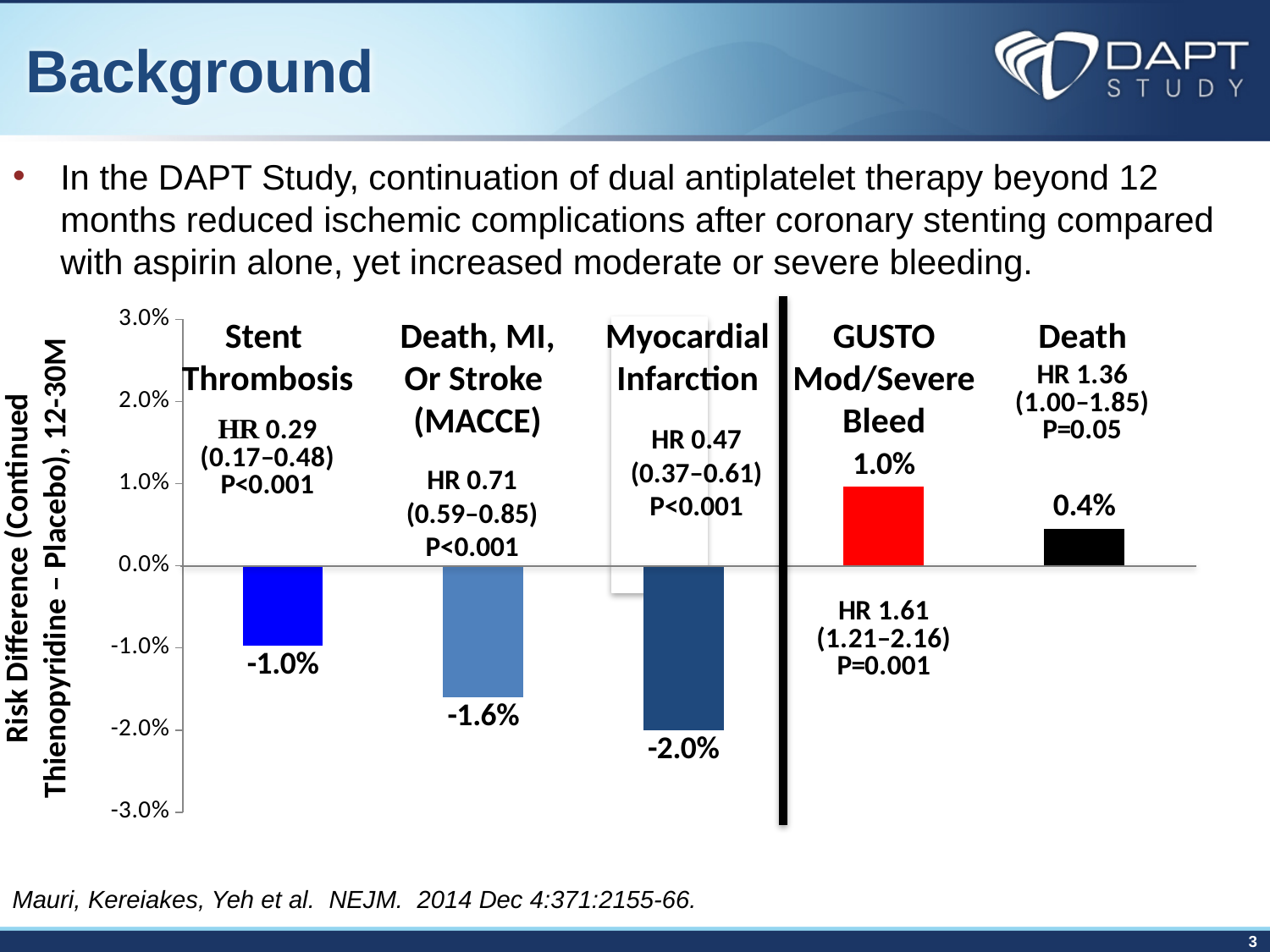
What is the risk difference for Myocardial Infarction? -2.0% What is the risk difference for Stent Thrombosis? -1.0% How many categories are plotted in the chart? 5 What is the y-axis label of the chart? Risk Difference (Continued Thienopyridine – Placebo), 12-30M What kind of chart is shown on the slide? Bar chart Which category has the lowest (most negative) risk difference? Myocardial Infarction Which is larger, the risk difference for GUSTO Mod/Severe Bleed or for Death? GUSTO Mod/Severe Bleed What is the risk difference for Death? 0.4% Which category has the highest risk difference? GUSTO Mod/Severe Bleed What is the risk difference for GUSTO Mod/Severe Bleed? 1.0% What is the difference between the risk difference for Death, MI, Or Stroke (MACCE) and for Stent Thrombosis? 0.6% What is the hazard ratio shown for Death, MI, Or Stroke (MACCE)? HR 0.71